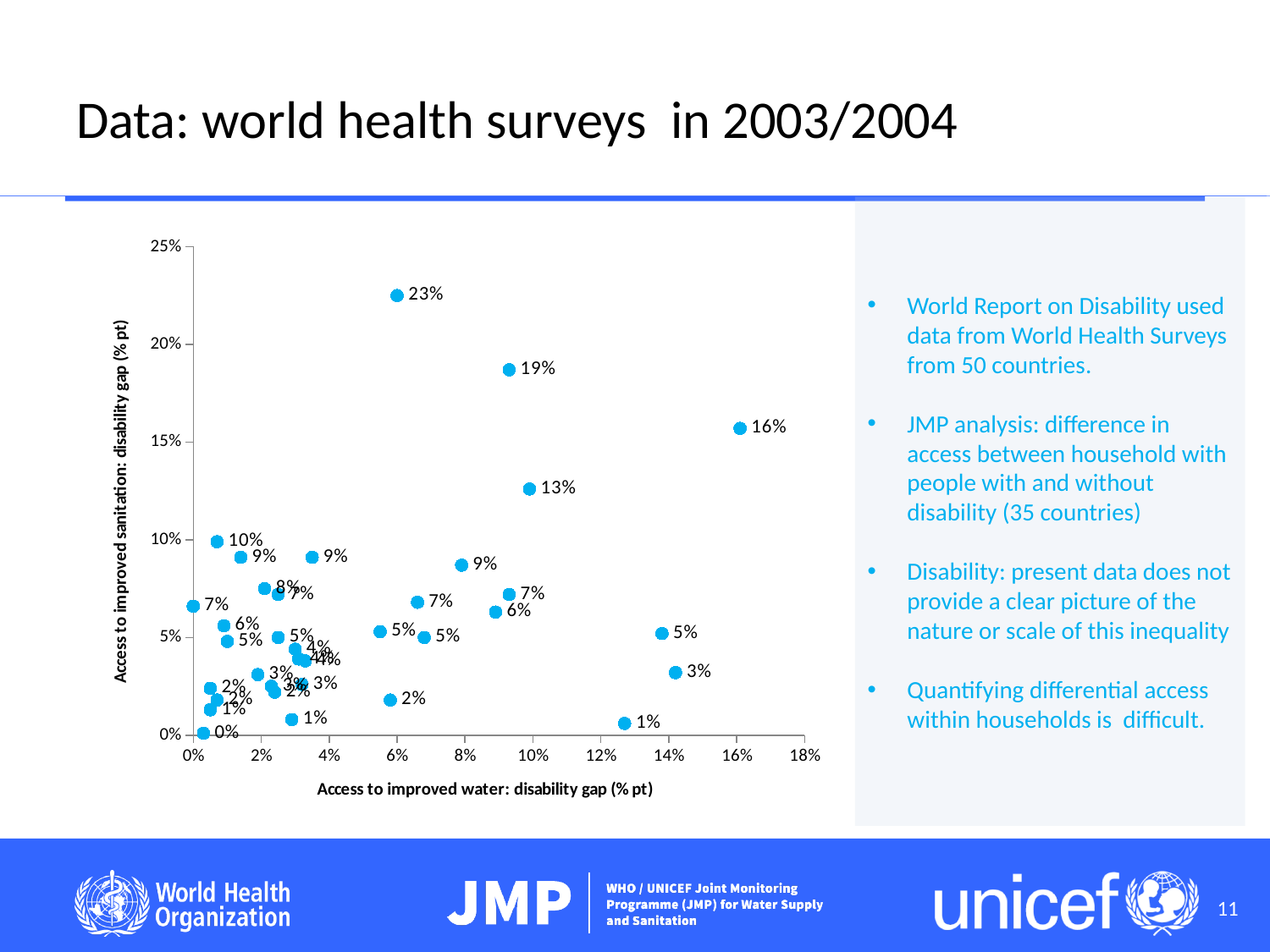
Is the water disability gap for the point labelled 19% greater or less than 6%? greater Is the water disability gap for the point labelled 10% greater or less than 2%? less Is the water disability gap for the point labelled 23% greater or less than 4%? greater What is the lowest sanitation disability gap value labelled on the chart? 0% What is the highest sanitation disability gap value labelled on the chart? 23% What is the maximum value shown on the vertical axis of the chart? 25% What kind of chart is shown on the slide? scatter chart What is the difference between the two highest labelled sanitation gap values (23% and 19%)? 4% What is the title of the horizontal axis of the chart? Access to improved water: disability gap (% pt) Which is larger: the sanitation gap of the point labelled 23% or the point labelled 19%? 23% What is the title of the vertical axis of the chart? Access to improved sanitation: disability gap (% pt)